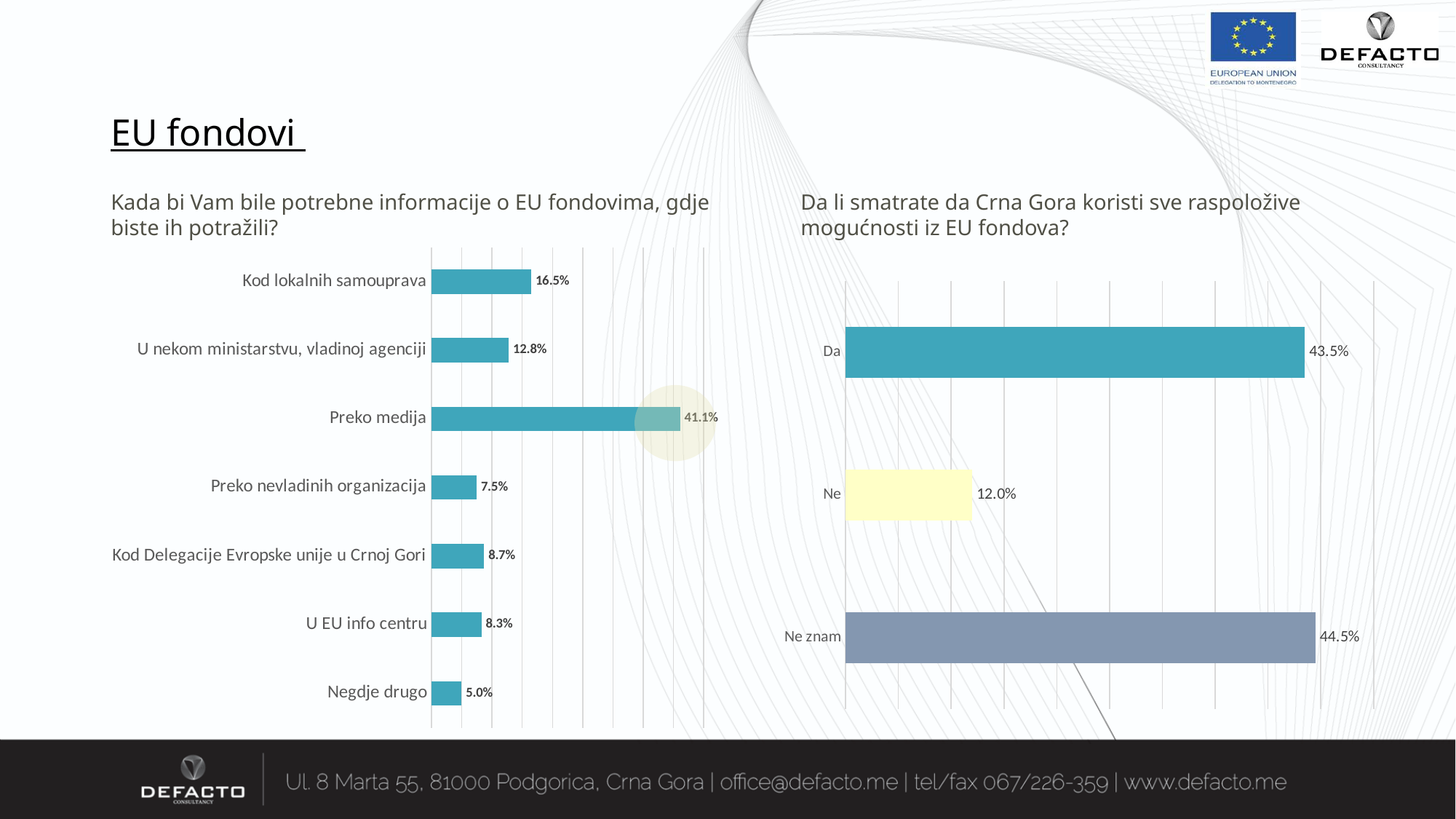
In the left chart (Kada bi Vam bile potrebne informacije o EU fondovima, gdje biste ih potražili?), which is larger: Kod Delegacije Evropske unije u Crnoj Gori or U EU info centru? Kod Delegacije Evropske unije u Crnoj Gori In the left chart (Kada bi Vam bile potrebne informacije o EU fondovima, gdje biste ih potražili?), which category has the lowest value? Negdje drugo In the left chart (Kada bi Vam bile potrebne informacije o EU fondovima, gdje biste ih potražili?), which category has the highest value? Preko medija What kind of chart is the right chart (Da li smatrate da Crna Gora koristi sve raspoložive mogućnosti iz EU fondova?)? Bar chart How many categories does the left chart (Kada bi Vam bile potrebne informacije o EU fondovima, gdje biste ih potražili?) show? 7 In the left chart (Kada bi Vam bile potrebne informacije o EU fondovima, gdje biste ih potražili?), what is the value for Preko medija? 41.1% In the right chart (Da li smatrate da Crna Gora koristi sve raspoložive mogućnosti iz EU fondova?), what is the value for Ne znam? 44.5% In the right chart (Da li smatrate da Crna Gora koristi sve raspoložive mogućnosti iz EU fondova?), what is the difference between Ne znam and Da? 1.0% How many categories does the right chart (Da li smatrate da Crna Gora koristi sve raspoložive mogućnosti iz EU fondova?) show? 3 In the right chart (Da li smatrate da Crna Gora koristi sve raspoložive mogućnosti iz EU fondova?), what is the value for Ne? 12.0% In the left chart (Kada bi Vam bile potrebne informacije o EU fondovima, gdje biste ih potražili?), what is the value for Kod lokalnih samouprava? 16.5% In the left chart (Kada bi Vam bile potrebne informacije o EU fondovima, gdje biste ih potražili?), what is the difference between Kod lokalnih samouprava and U nekom ministarstvu, vladinoj agenciji? 3.7%